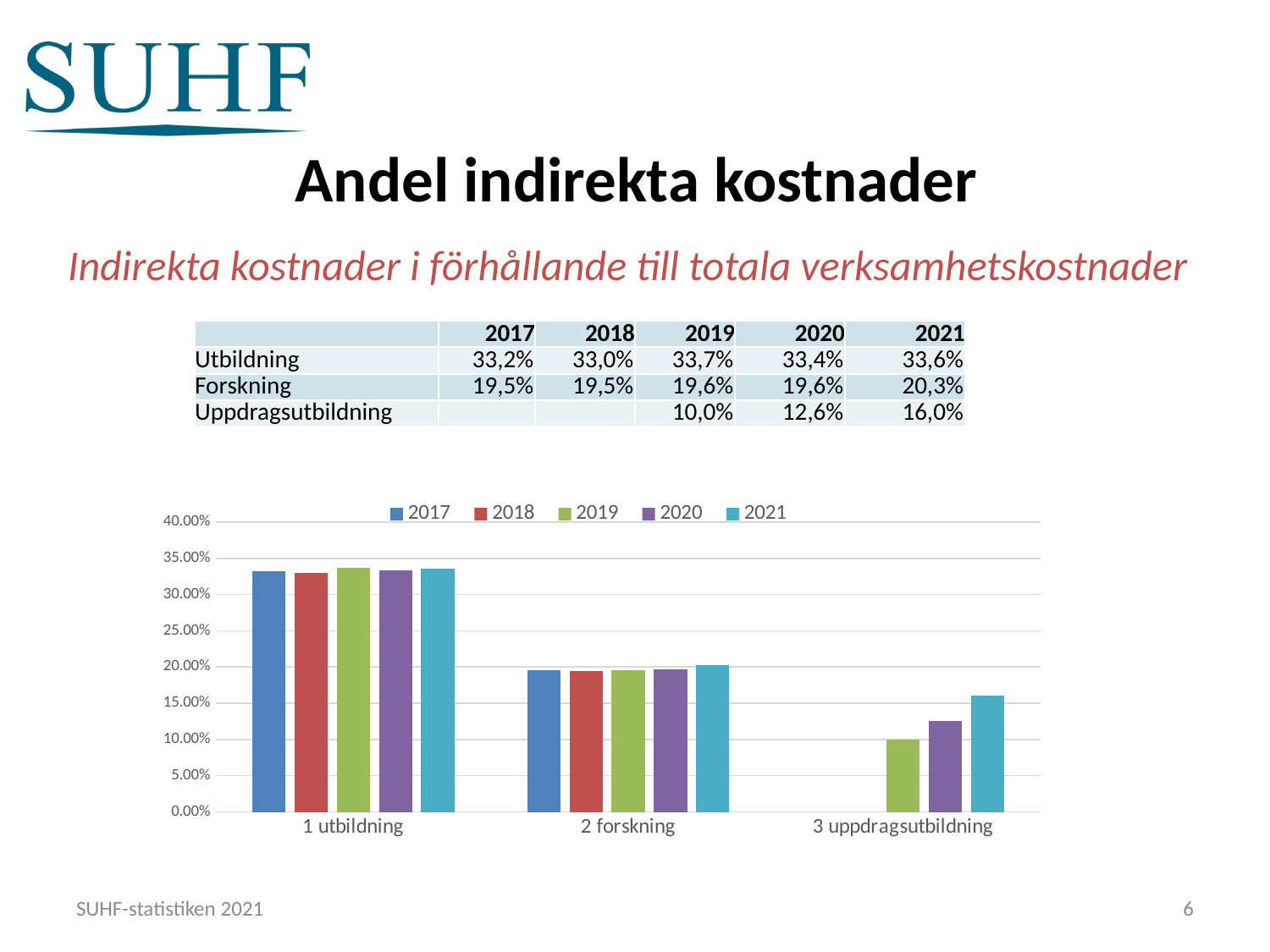
How many series does the chart legend list? 5 Which year has the lowest value for Utbildning? 2018 Which is larger, the 2017 value for Utbildning or the 2017 value for Forskning? Utbildning According to the table, what is the value for Forskning in 2019? 19,6% Do the values for Uppdragsutbildning rise or fall from 2019 to 2021? rise Which year has the highest value for Uppdragsutbildning? 2021 What is the difference between the 2021 and 2019 values for Uppdragsutbildning? 6,0% What kind of chart is shown on the slide? bar chart According to the table, what is the value for Utbildning in 2021? 33,6% Is the 2021 value for Forskning greater or less than 20.00%? greater According to the table, what is the value for Uppdragsutbildning in 2020? 12,6% How many categories are shown on the x axis of the chart? 3